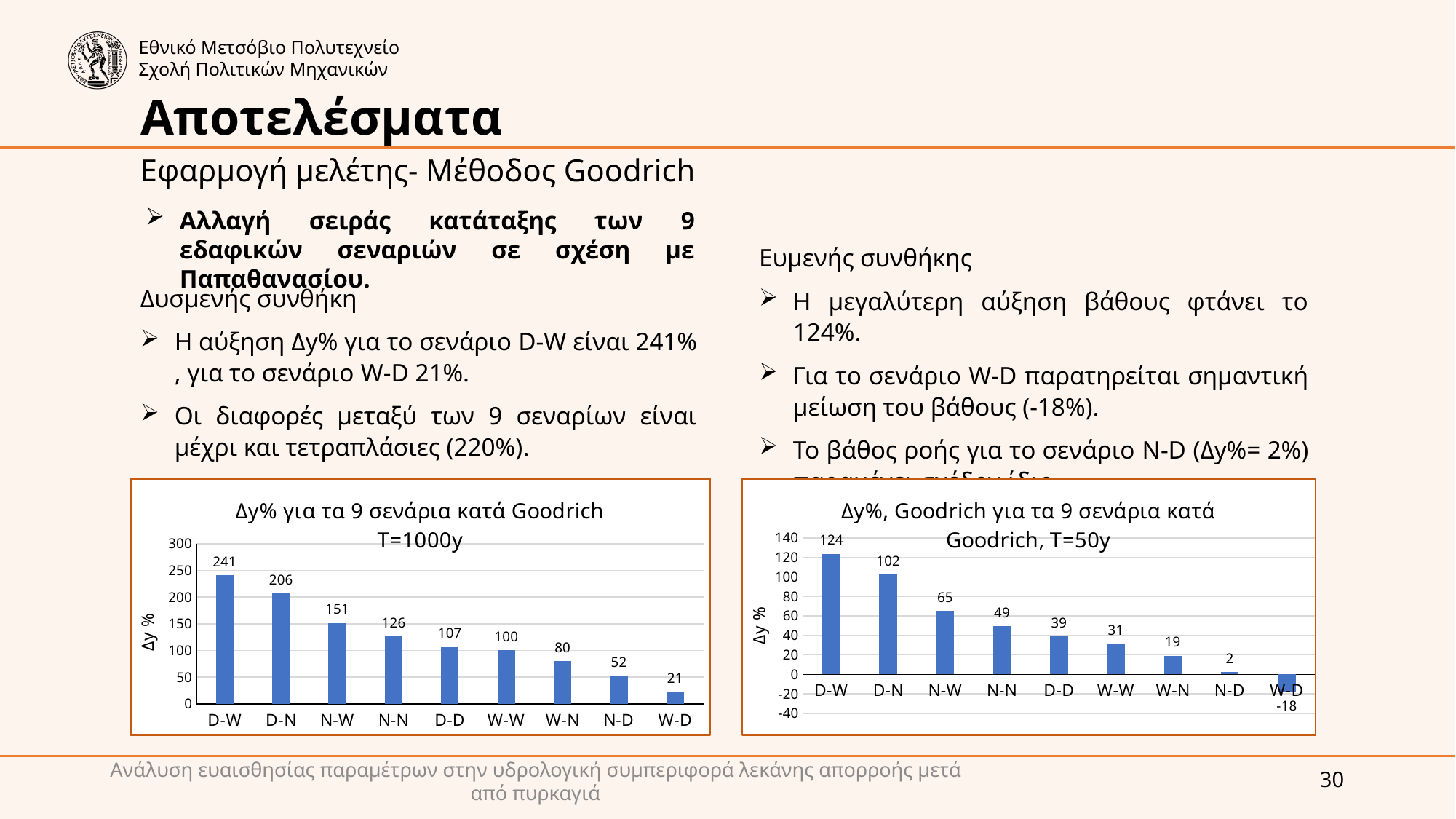
In the left chart (T=1000y), which scenario has the lowest Δy% value? W-D In the left chart (T=1000y), how many scenarios are shown on the x axis? 9 What type of chart is the left chart (T=1000y)? bar chart In the right chart (T=50y), what is the Δy% value for scenario W-D? -18 In the right chart (T=50y), which scenario has the highest Δy% value? D-W What is the y-axis label of the right chart (T=50y)? Δy % In the left chart (T=1000y), what is the difference between the values for D-W and W-D? 220 In the right chart (T=50y), which is larger, the value for N-W or the value for D-D? N-W In the left chart (T=1000y), do the values rise or fall from left to right along the x axis? fall In the left chart (T=1000y), what is the Δy% value for scenario D-W? 241 In the right chart (T=50y), what is the value for scenario N-D? 2 In the right chart (T=50y), what is the difference between the values for D-W and D-N? 22